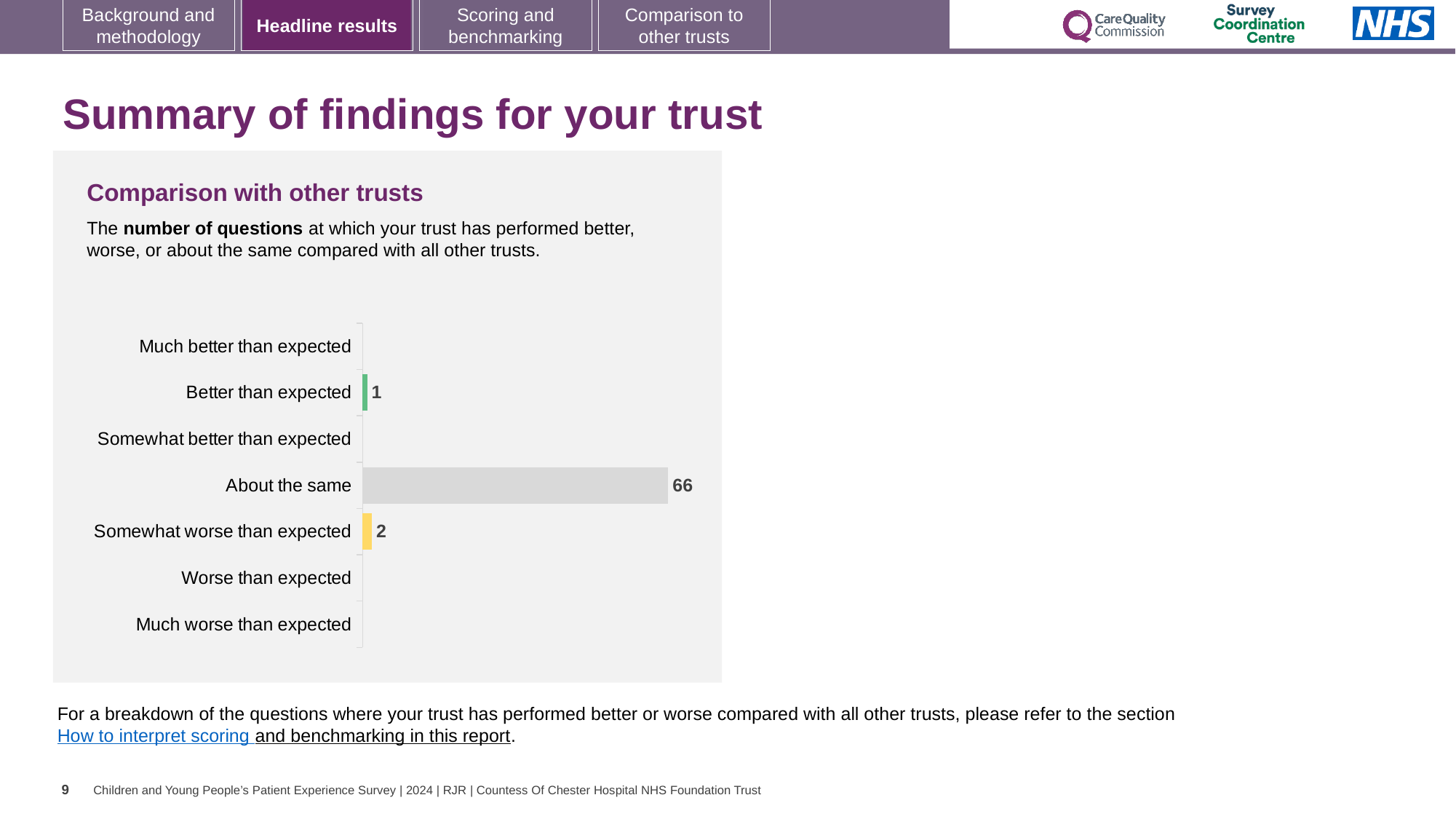
What is the difference between 'Somewhat worse than expected' and 'Better than expected'? 1 How many questions did the trust perform 'About the same' on compared with other trusts? 66 What is the value for 'Somewhat worse than expected'? 2 What kind of chart is shown on the slide? Bar chart What is the total number of questions across the three labelled bars? 69 Which is larger: the value for 'Better than expected' or the value for 'Somewhat worse than expected'? Somewhat worse than expected Which category has the highest number of questions? About the same What is the title of the chart? Comparison with other trusts What is the difference between the 'About the same' value and the 'Somewhat worse than expected' value? 64 What is the value for 'Better than expected'? 1 How many categories have a visible bar with a data label? 3 How many categories are listed on the chart's axis? 7